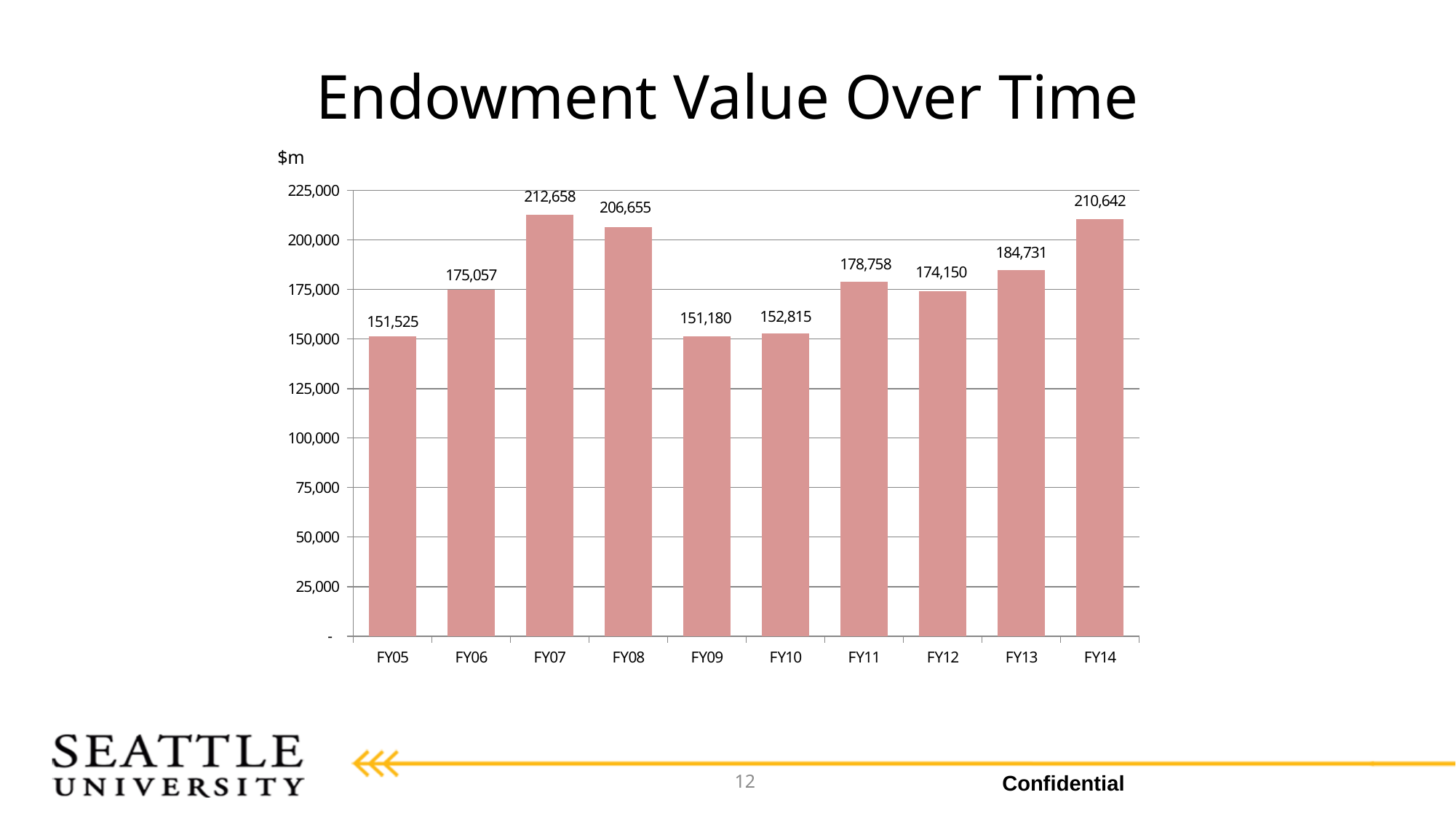
Which fiscal year has the lowest endowment value? FY09 What is the difference between the endowment values for FY14 and FY13? 25,911 What kind of chart is shown on the slide? bar chart How many fiscal years are shown on the chart? 10 Which fiscal year has the highest endowment value? FY07 Which is larger, the endowment value for FY06 or FY11? FY11 What is the endowment value for FY07? 212,658 Is the endowment value for FY13 greater or less than 175,000? greater What is the endowment value for FY12? 174,150 What unit is indicated above the vertical axis of the chart? $m What is the endowment value for FY14? 210,642 What is the difference between the endowment values for FY08 and FY09? 55,475